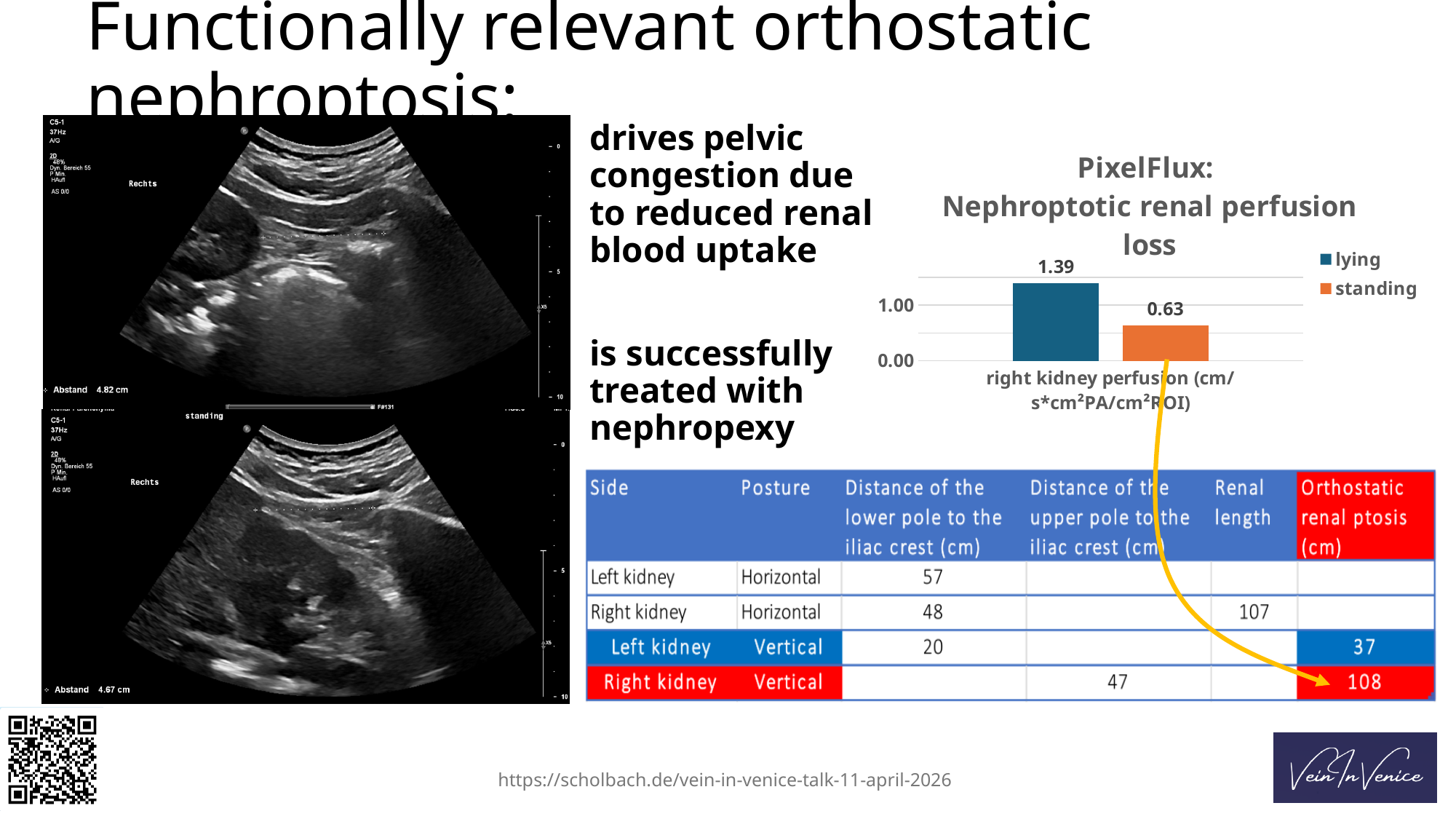
Is the value for 'standing' in the PixelFlux chart greater or less than 1.00? less What colour is the 'standing' bar in the PixelFlux chart? orange How many series does the legend of the PixelFlux chart list? 2 What kind of chart is the PixelFlux chart? bar chart What is the title of the chart on the slide? PixelFlux: Nephroptotic renal perfusion loss What is the difference between the lying and standing values in the PixelFlux chart? 0.76 What is the value of the 'lying' bar in the PixelFlux chart? 1.39 Is the value for 'lying' in the PixelFlux chart greater or less than 1.00? greater Which series has the lowest value in the PixelFlux chart? standing How many bars are plotted in the PixelFlux chart? 2 Which series has the higher value in the PixelFlux chart, lying or standing? lying What is the value of the 'standing' bar in the PixelFlux chart? 0.63